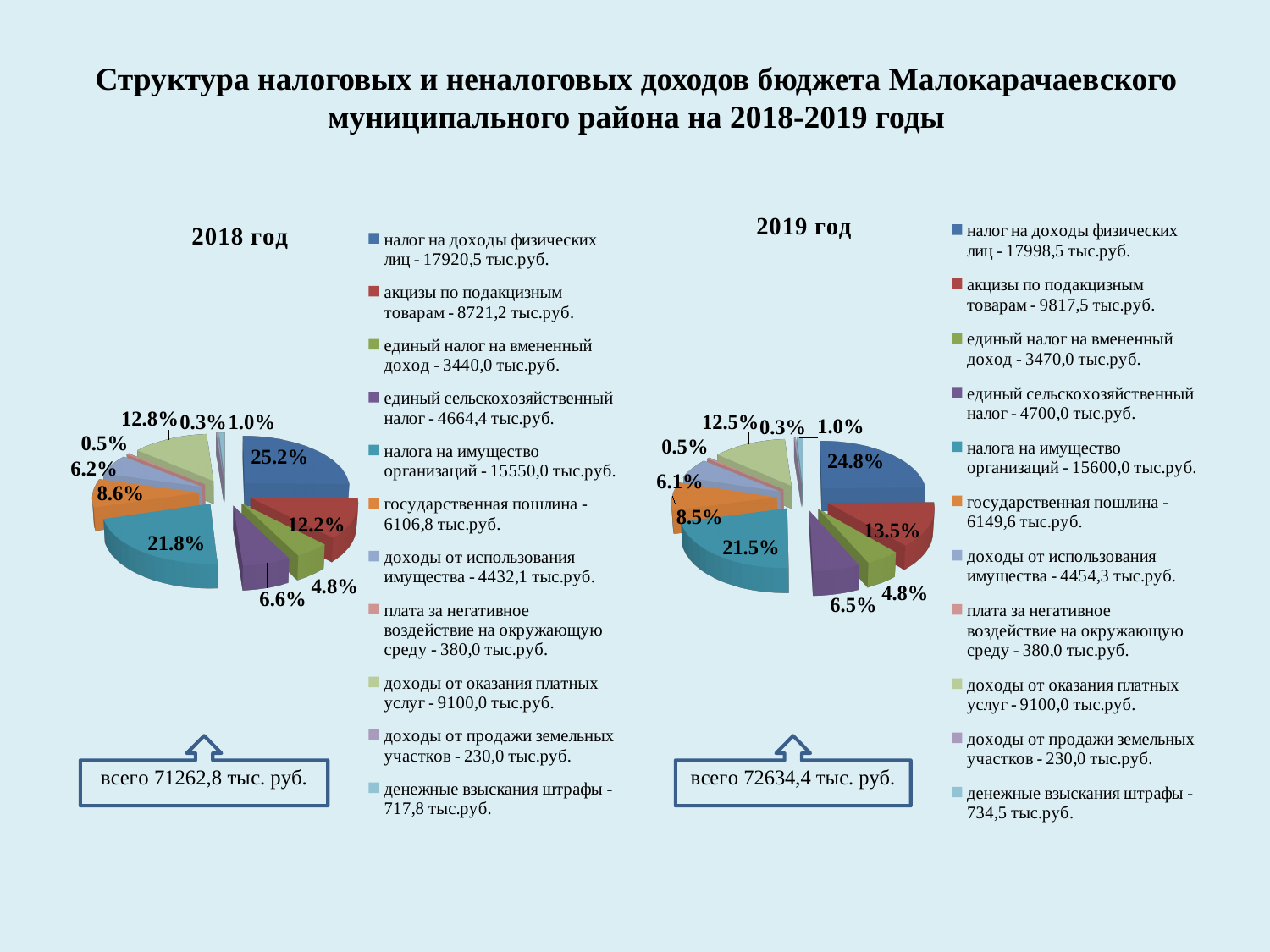
On the 2018 год chart, which category has the largest slice? налог на доходы физических лиц On the 2019 год chart, what share of the pie is the slice for акцизы по подакцизным товарам? 13.5% On the 2018 год chart, what share of the pie is the slice for налог на доходы физических лиц? 25.2% According to the legend of the 2019 год chart, what is the value for государственная пошлина? 6149,6 тыс.руб. What type of chart is used for 2019 год? pie chart On the 2019 год chart, which category has the smallest slice? доходы от продажи земельных участков On the 2018 год chart, what share of the pie is the slice for доходы от оказания платных услуг? 12.8% On the 2018 год chart, what is the difference in percentage points between the акцизы по подакцизным товарам slice and the государственная пошлина slice? 3.6 What total is shown in the box below the 2018 год chart? всего 71262,8 тыс. руб. How many slices does the 2018 год pie chart have? 11 On the 2019 год chart, which slice is larger: единый сельскохозяйственный налог or доходы от использования имущества? единый сельскохозяйственный налог